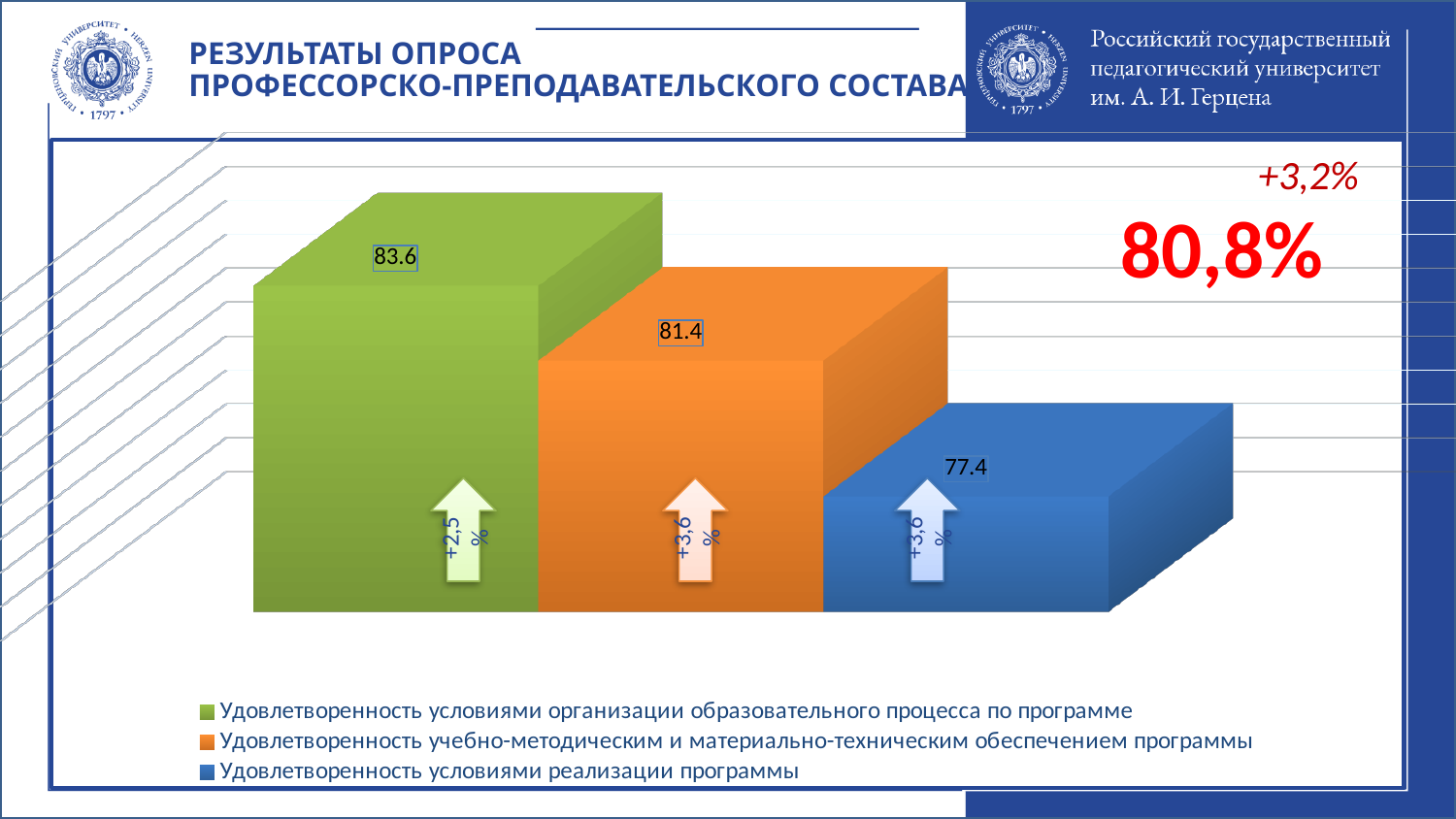
How many entries does the legend list? 3 What is the difference between the green bar (83.6) and the blue bar (77.4)? 6.2 What value is shown for the blue bar, 'Удовлетворенность условиями реализации программы'? 77.4 What value is shown for the green bar, 'Удовлетворенность условиями организации образовательного процесса по программе'? 83.6 How many bars are plotted on the chart? 3 What overall percentage is shown in large red text at the top right of the chart? 80,8% Which legend entry has the lowest value on the chart? Удовлетворенность условиями реализации программы What kind of chart is shown on the slide? Bar chart What value is shown for the orange bar, 'Удовлетворенность учебно-методическим и материально-техническим обеспечением программы'? 81.4 Which legend entry has the highest value on the chart? Удовлетворенность условиями организации образовательного процесса по программе What is the difference between the green bar (83.6) and the orange bar (81.4)? 2.2 Which is larger: the value for the orange bar or the value for the blue bar? The orange bar (81.4)